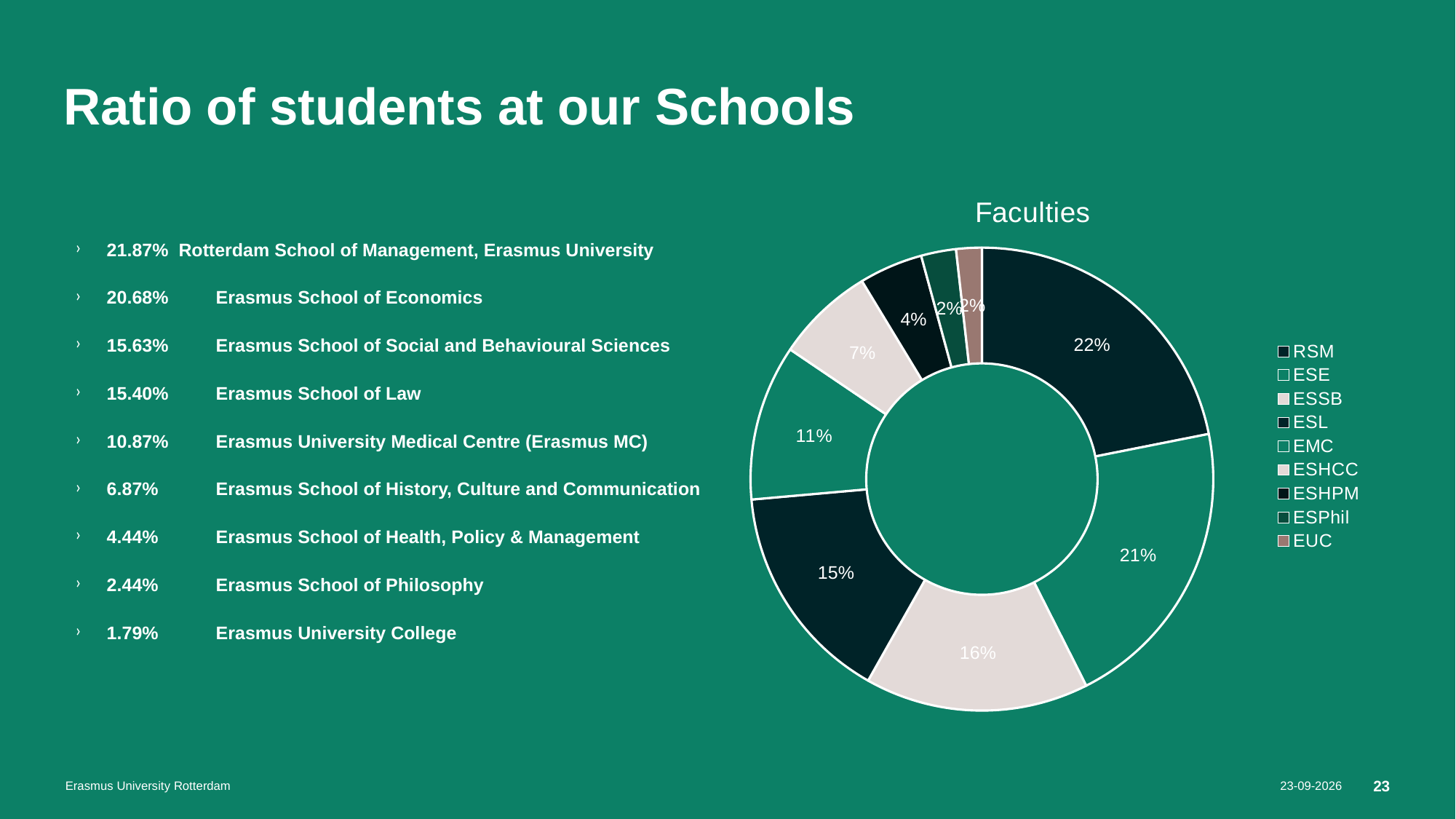
Which slice is larger, ESL or ESHCC? ESL What kind of chart is shown on the slide? doughnut chart Which faculty has the largest slice in the chart? RSM What percentage does the chart show for ESSB? 16% What is the difference in percentage points between the ESE slice and the EMC slice? 10 How many slices does the doughnut chart have? 9 What percentage does the chart show for RSM? 22% What is the difference in percentage points between the RSM slice and the ESL slice? 7 What is the title of the chart? Faculties What percentage does the chart show for ESHPM? 4% How many entries does the chart legend list? 9 What percentage does the chart show for EMC? 11%